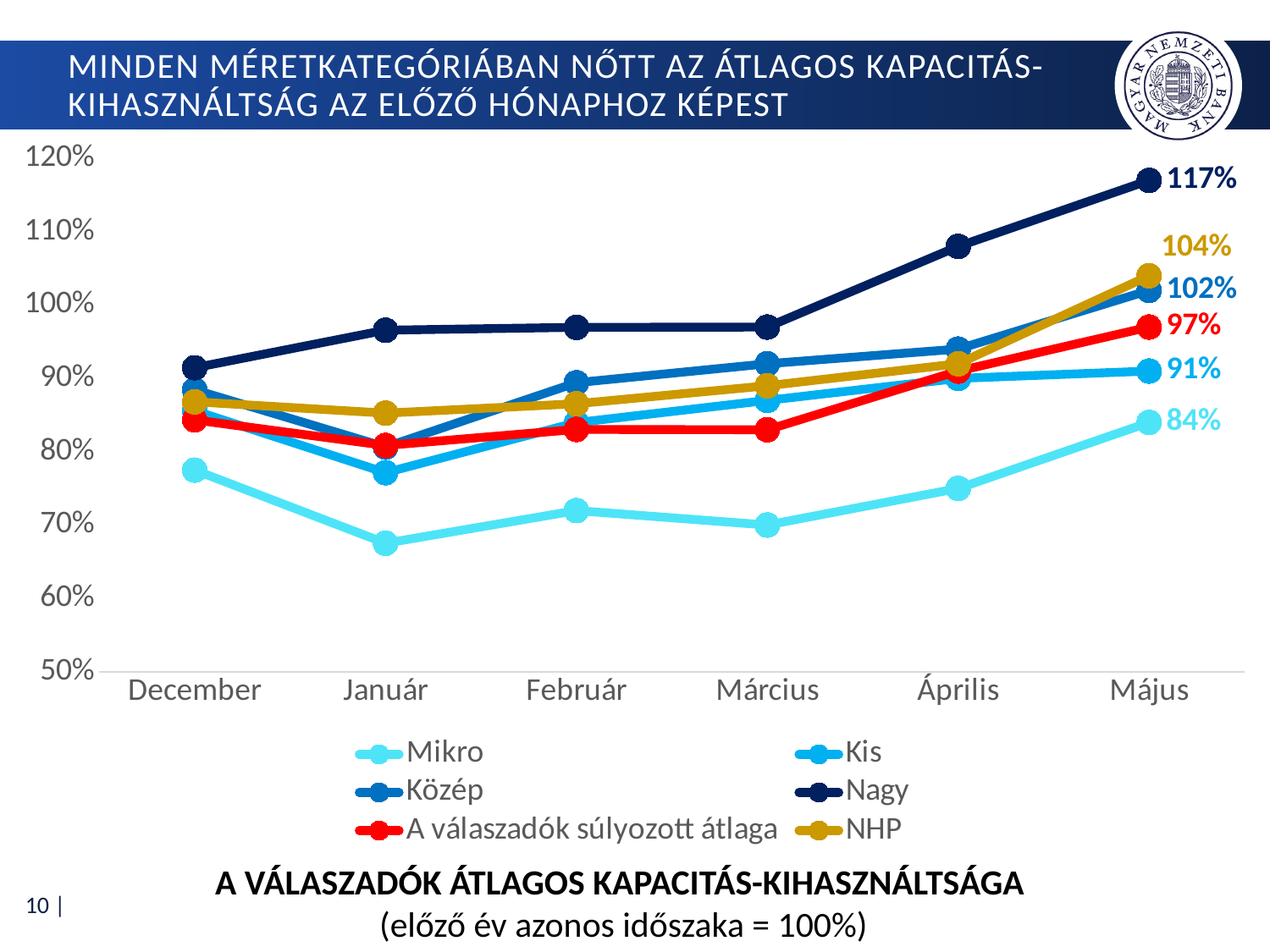
How many months are shown on the x axis? 6 What is the difference between the Nagy and Mikro values in Május? 33 percentage points What type of chart is shown on the slide? line chart Which series has the lowest value in Május? Mikro What is the value for NHP in Május? 104% What is the value for Nagy in Május? 117% Which series has the highest value in Május? Nagy How many series does the legend list? 6 Does the Nagy series rise or fall from Március to Május? rise What is the value for A válaszadók súlyozott átlaga in Május? 97% What is the value for Mikro in Május? 84% Is the value for Mikro in Január greater or less than 70%? less